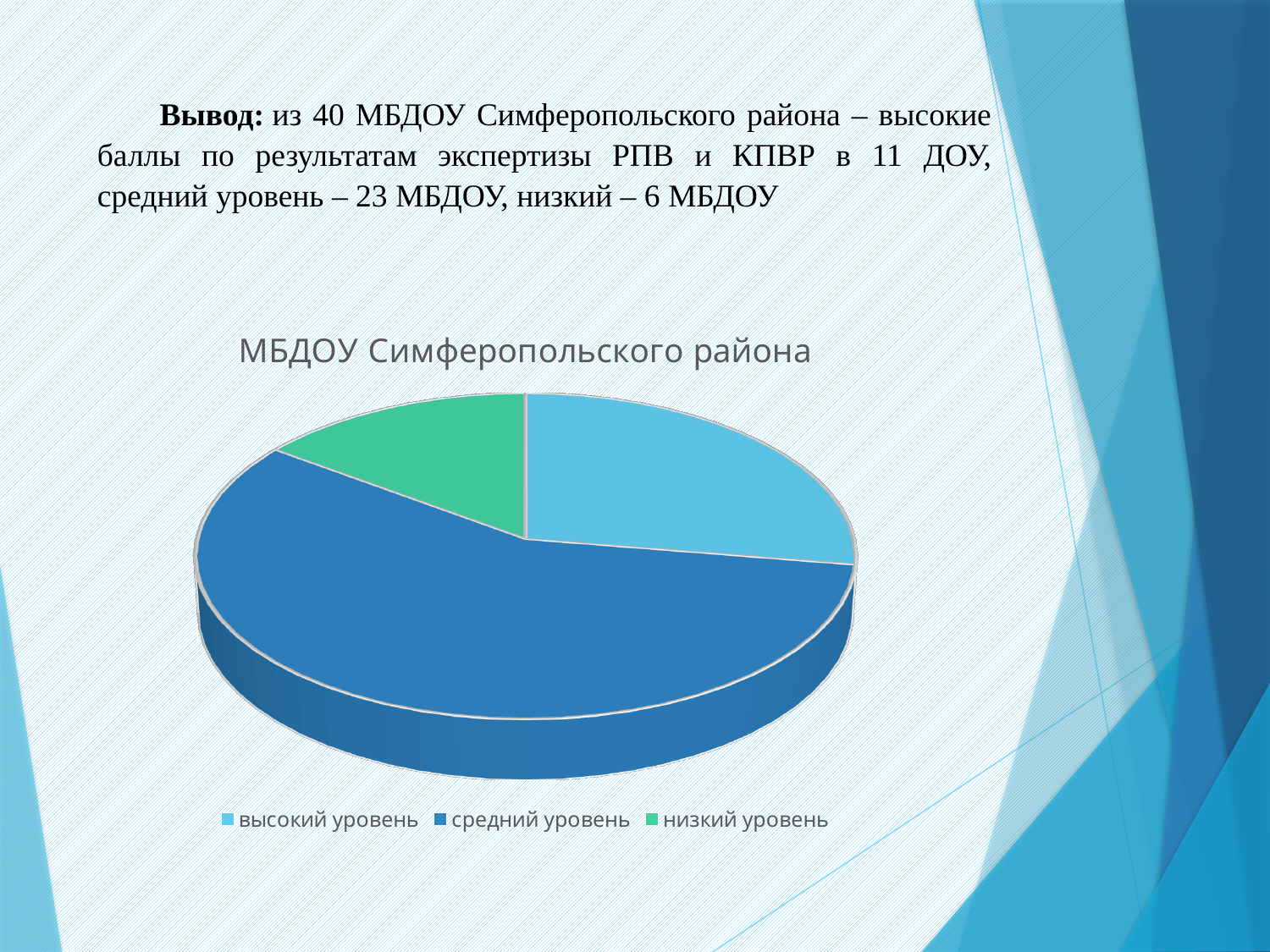
Which slice is larger: средний уровень or высокий уровень? средний уровень Which category is shown in green in the pie chart? низкий уровень What is the title of the chart? МБДОУ Симферопольского района Which category has the smallest slice of the pie? низкий уровень What kind of chart is shown on the slide? pie chart How many slices does the pie chart have? 3 How many entries does the chart legend list? 3 Which category has the largest slice of the pie? средний уровень Does the slice for средний уровень cover more or less than half of the pie? more Which slice is larger: высокий уровень or низкий уровень? высокий уровень